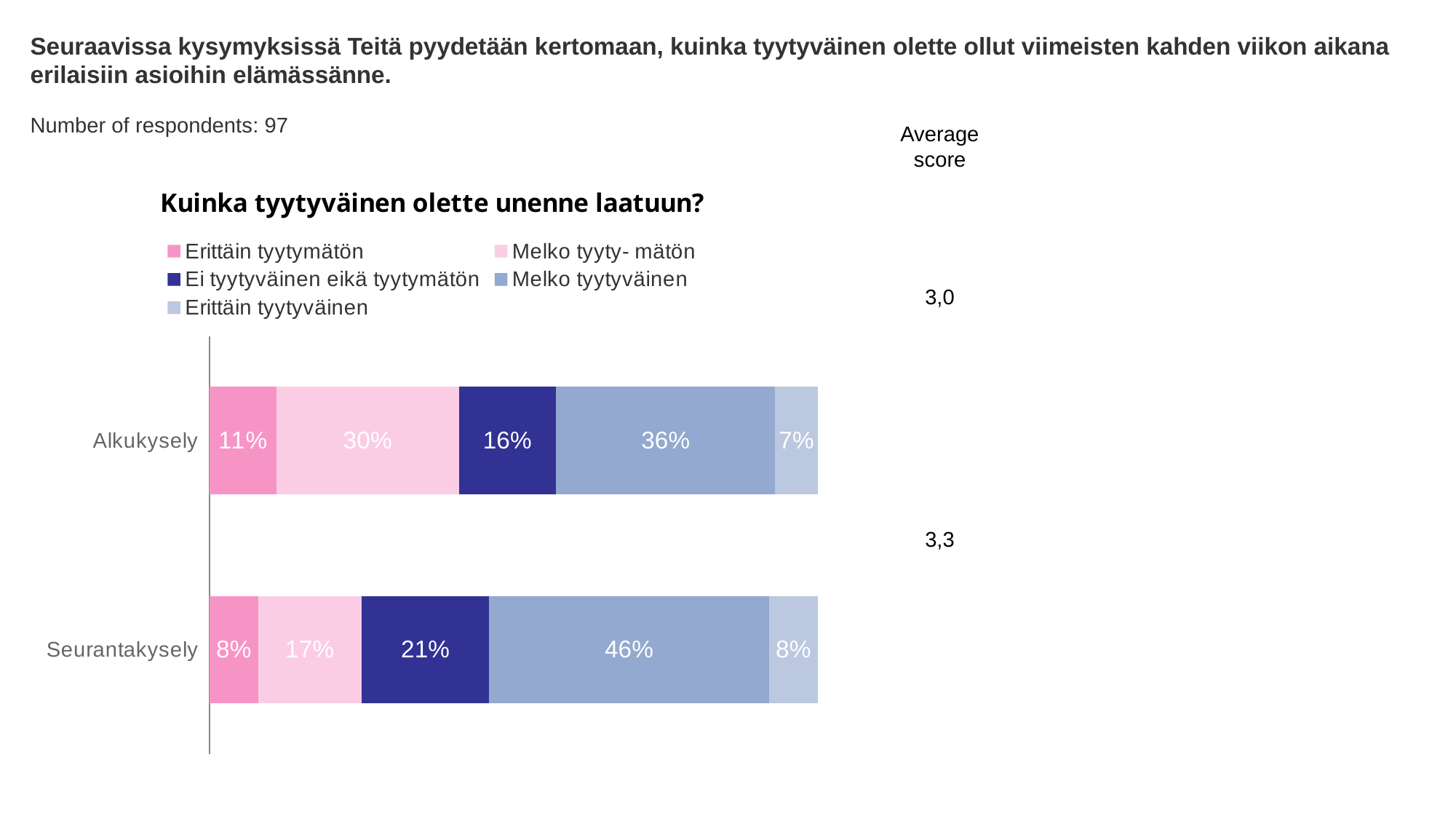
What is the average score shown for Seurantakysely? 3,3 Which segment is the smallest in the Alkukysely bar? Erittäin tyytyväinen Which segment is the largest in the Seurantakysely bar? Melko tyytyväinen What kind of chart is shown on the slide? Stacked bar chart Which bar has the larger Melko tyytymätön value, Alkukysely or Seurantakysely? Alkukysely What is the title of the chart? Kuinka tyytyväinen olette unenne laatuun? What is the value for Melko tyytyväinen in the Alkukysely bar? 36% How many series does the legend list? 5 What is the difference between the Melko tyytyväinen values for Seurantakysely and Alkukysely? 10 percentage points What is the value for Erittäin tyytymätön in the Seurantakysely bar? 8% What is the value for Ei tyytyväinen eikä tyytymätön in the Seurantakysely bar? 21% How many categories (bars) are shown in the chart? 2